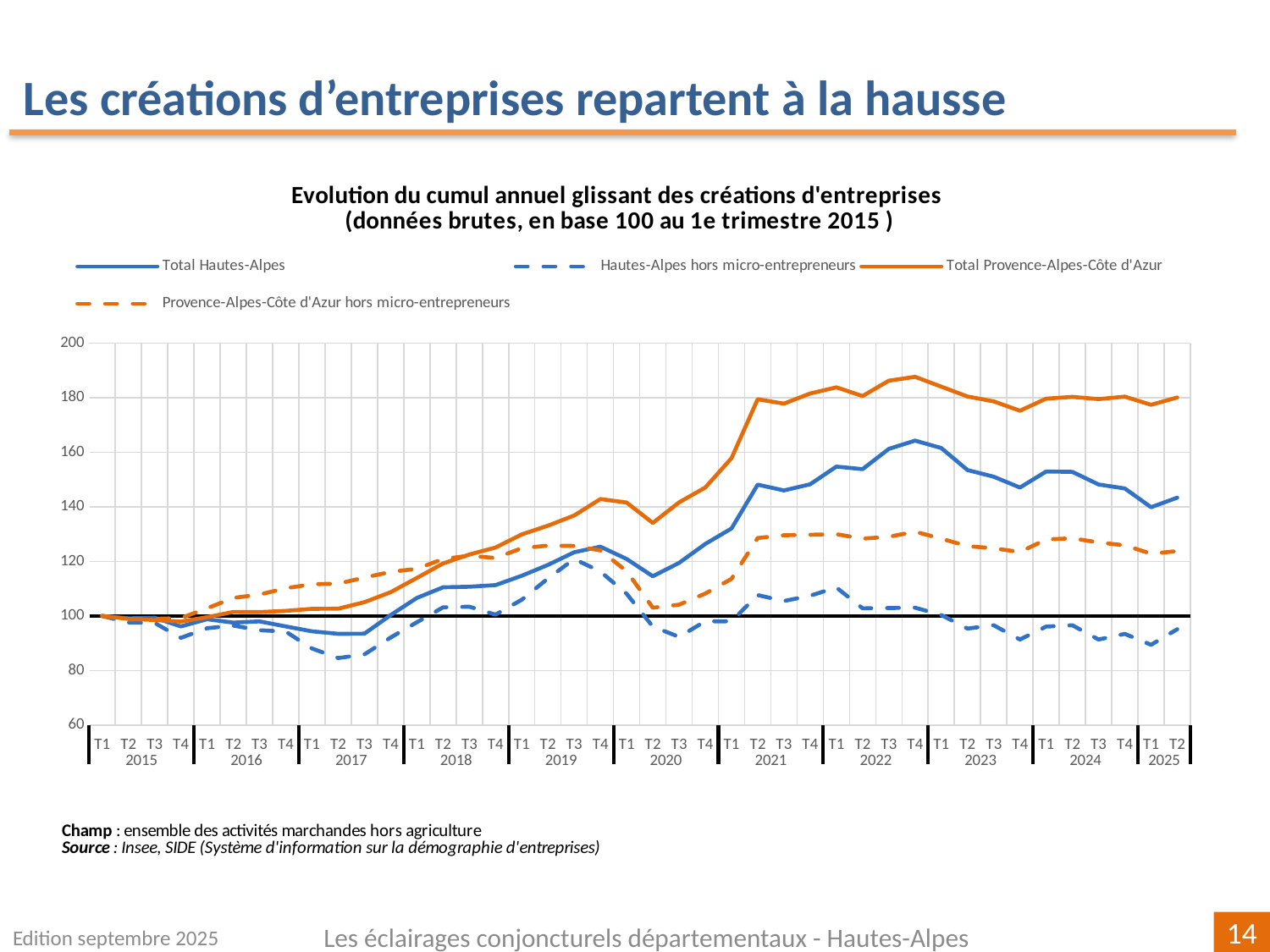
Is the value for Total Provence-Alpes-Côte d'Azur at T4 2022 greater or less than 180? greater How many years are labelled on the x axis? 11 At T2 2025, which is larger: Total Provence-Alpes-Côte d'Azur or Total Hautes-Alpes? Total Provence-Alpes-Côte d'Azur Does the Total Hautes-Alpes series rise or fall between T4 2022 and T1 2025? fall Is the value for Total Hautes-Alpes at T4 2022 greater or less than 160? greater Is the value for Hautes-Alpes hors micro-entrepreneurs at T2 2017 greater or less than 100? less At T4 2022, which is larger: Total Hautes-Alpes or Provence-Alpes-Côte d'Azur hors micro-entrepreneurs? Total Hautes-Alpes What kind of chart is shown on the slide? line chart Which series reaches the highest value on the chart? Total Provence-Alpes-Côte d'Azur What is the base period of the index used in the chart (base 100)? 1e trimestre 2015 How many series does the legend list? 4 Which series has the lowest value at T2 2025? Hautes-Alpes hors micro-entrepreneurs